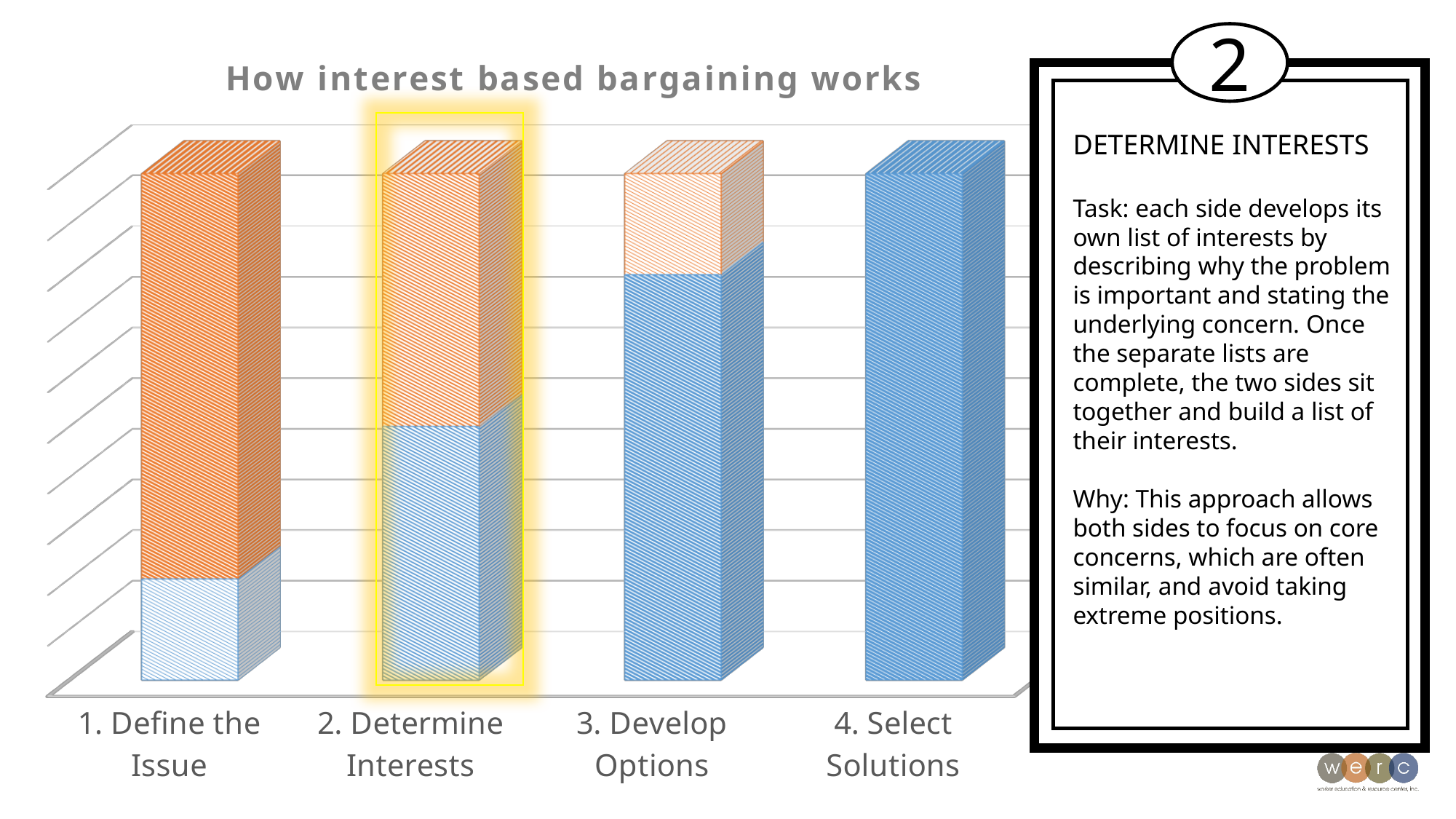
Does the orange segment rise or fall moving from left to right across the categories? Fall How many categories are shown on the x axis of the chart? 4 Which category is highlighted with a yellow box on the chart? 2. Determine Interests Which category has the largest blue segment? 4. Select Solutions Which category has the largest orange segment? 1. Define the Issue Is the blue segment larger for 1. Define the Issue or for 2. Determine Interests? 2. Determine Interests What is the title of the chart? How interest based bargaining works Which category has the smallest blue segment? 1. Define the Issue Does the blue segment rise or fall moving from left to right across the categories? Rise Which category has the smallest orange segment? 4. Select Solutions Is the orange segment larger for 2. Determine Interests or for 3. Develop Options? 2. Determine Interests What kind of chart is shown on the slide? Stacked bar chart